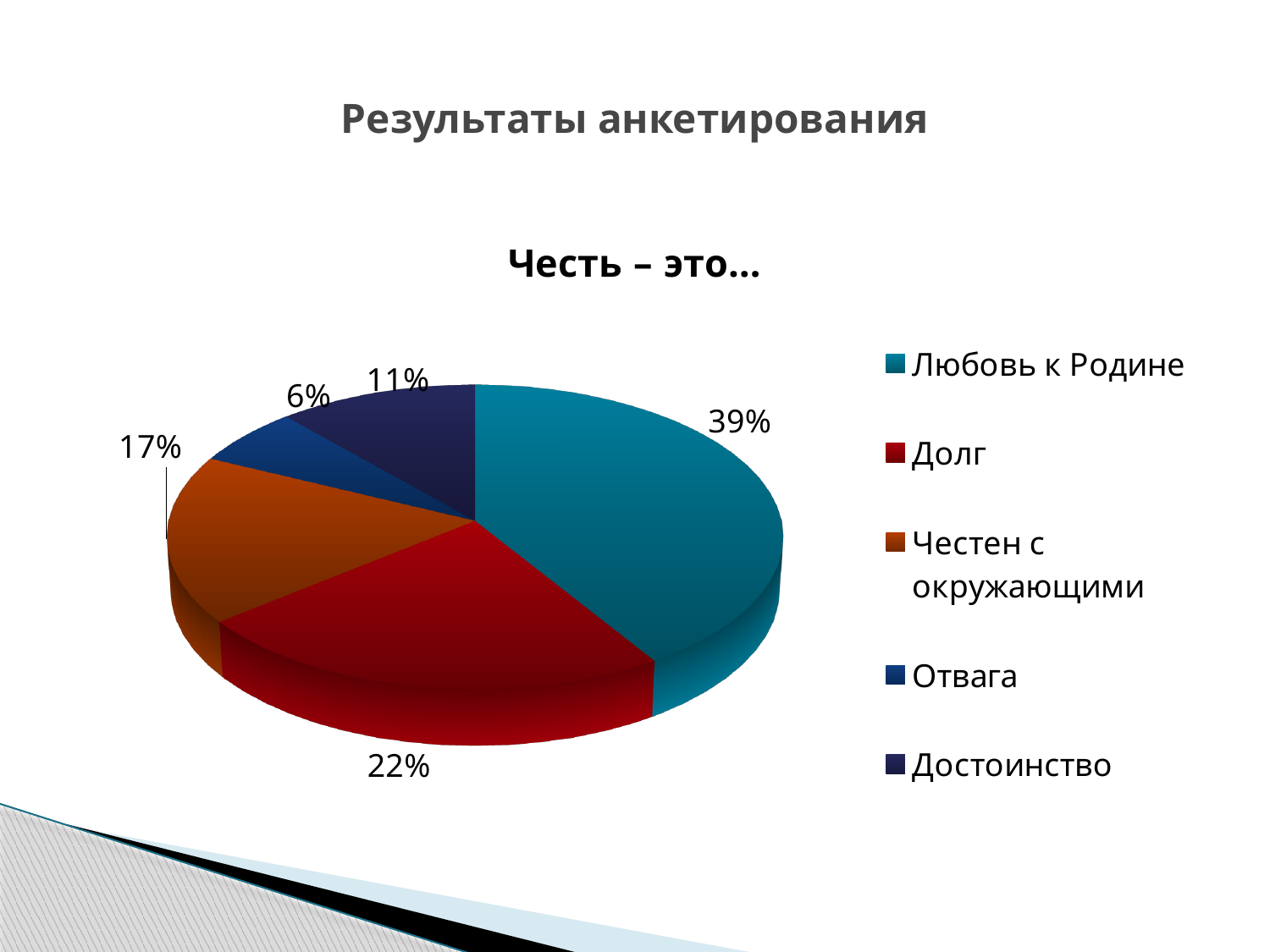
How many categories does the legend list? 5 What share of the pie does "Достоинство" have? 11% Which category has the largest slice of the pie? Любовь к Родине What share of the pie does "Отвага" have? 6% What is the difference between the shares for "Любовь к Родине" and "Долг"? 17% What share of the pie does "Долг" have? 22% What kind of chart is shown on the slide? pie chart What is the title of the chart? Честь – это… Which category has the smallest slice of the pie? Отвага What share of the pie does "Любовь к Родине" have? 39% What share of the pie does "Честен с окружающими" have? 17% Which is larger, the share for "Достоинство" or the share for "Отвага"? Достоинство